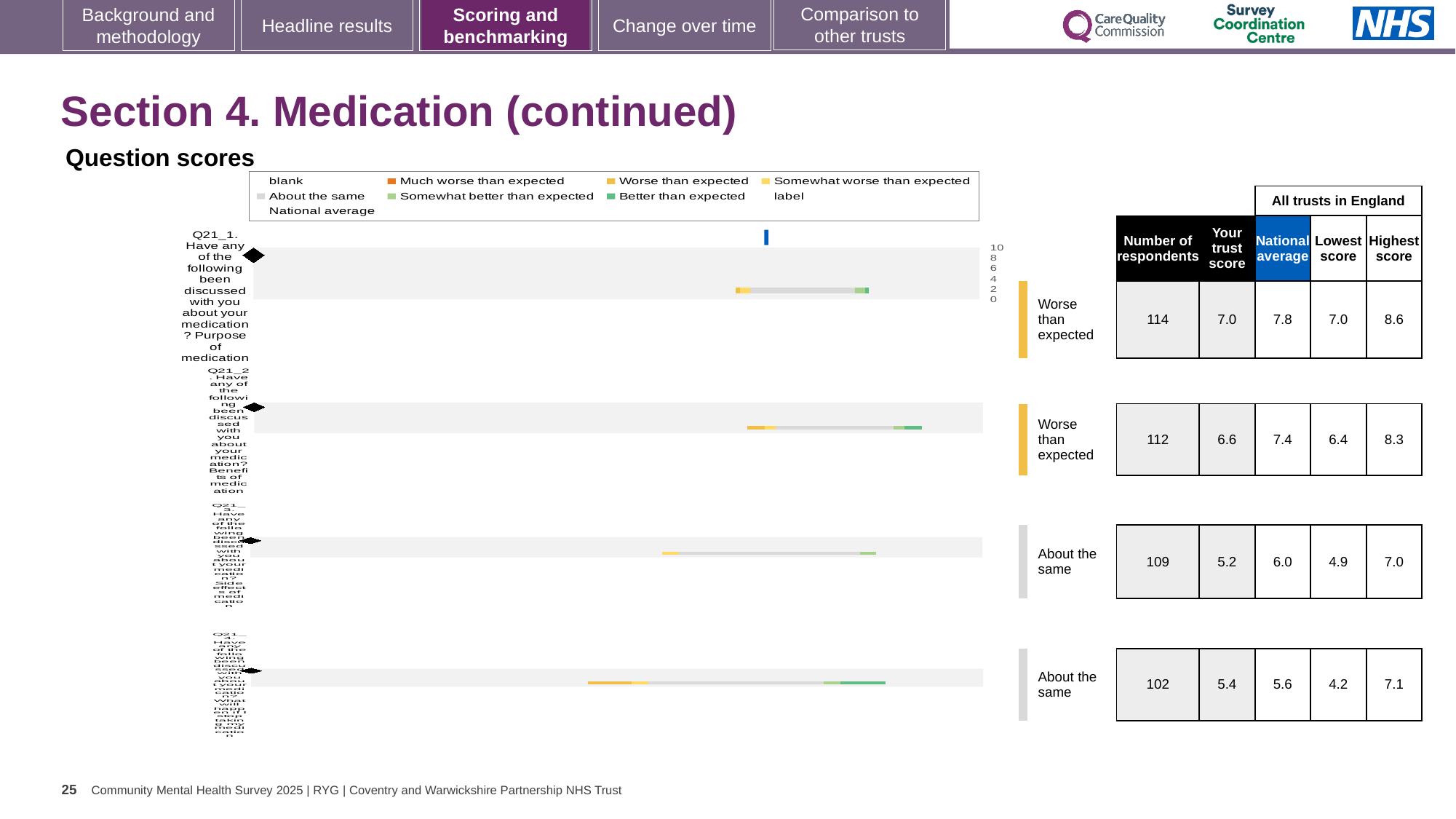
What is the highest score across all trusts in England for the fourth question row (Q21_4)? 7.1 What is the difference between the national average and the trust score for Q21_2? 0.8 How many respondents answered the third question row (Q21_3, Side effects of medication)? 109 How many question rows (categories) are plotted in the Question scores chart? 4 What is the trust score for Q21_1 (Purpose of medication)? 7.0 What kind of chart is shown under 'Question scores'? bar chart Which question row has the lowest number of respondents? Q21_4 Which is larger: the trust score for the third question row (5.2) or the fourth question row (5.4)? the fourth question row (5.4) What is the national average for Q21_2 (Benefits of medication)? 7.4 What benchmark category is shown next to the Q21_1 row? Worse than expected Which question row has the highest trust score? Q21_1 How many entries does the legend of the Question scores chart list? 9